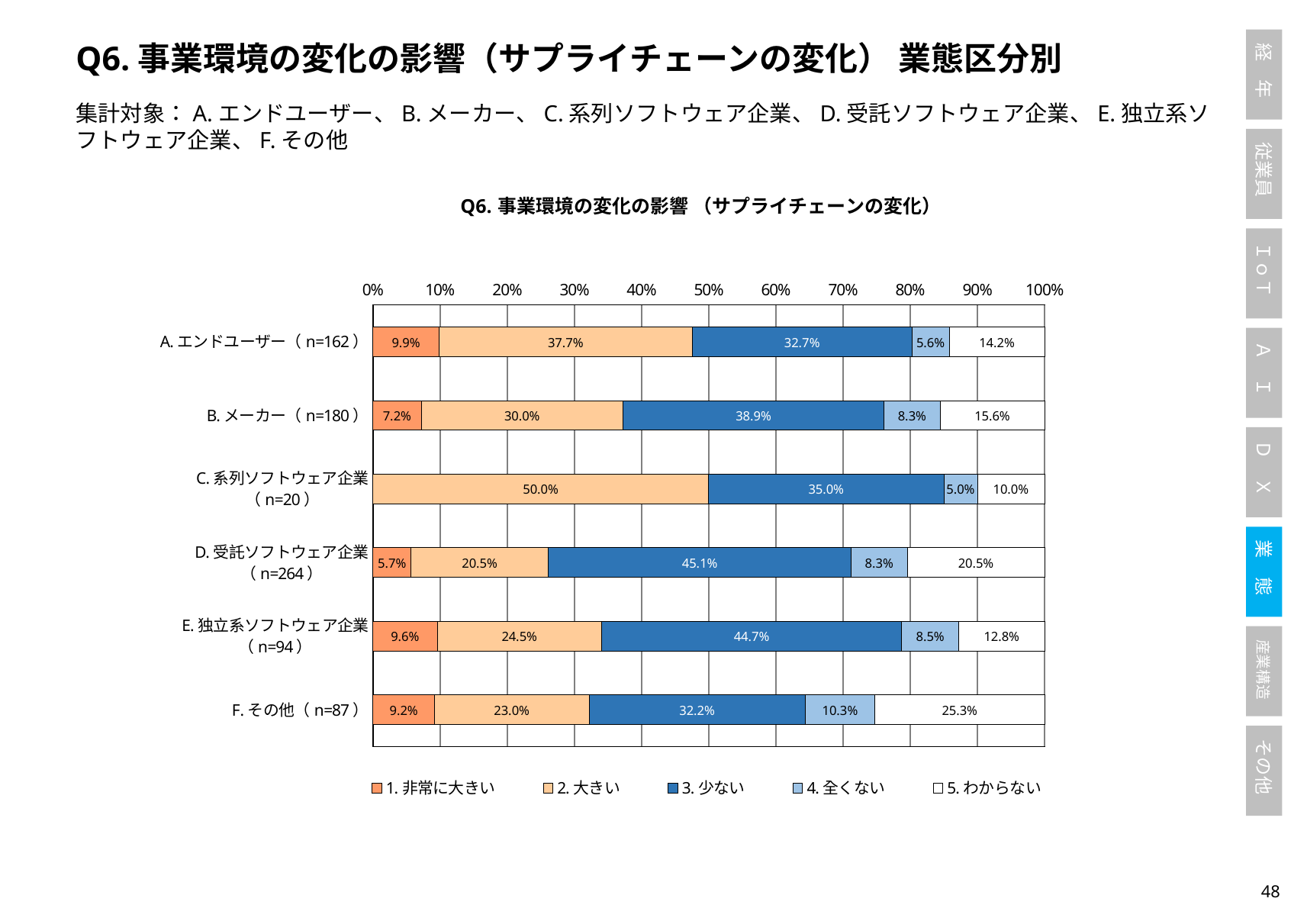
What is the difference between the "2. 大きい" and "3. 少ない" values for A. エンドユーザー (n=162)? 5.0 percentage points What is the value of "3. 少ない" for D. 受託ソフトウェア企業 (n=264)? 45.1% What is the total of the stacked bar for B. メーカー (n=180)? 100.0% Which category has the lowest value for "5. わからない"? C. 系列ソフトウェア企業 (n=20) What kind of chart is shown on the slide? Stacked bar chart What is the value of "2. 大きい" for A. エンドユーザー (n=162)? 37.7% Which is larger: the "1. 非常に大きい" value for A. エンドユーザー or for B. メーカー? A. エンドユーザー What is the first entry in the chart's legend? 1. 非常に大きい What is the value of "5. わからない" for F. その他 (n=87)? 25.3% How many series does the legend list? 5 Which category has the highest value for "2. 大きい"? C. 系列ソフトウェア企業 (n=20) How many categories (business types) are shown on the chart? 6